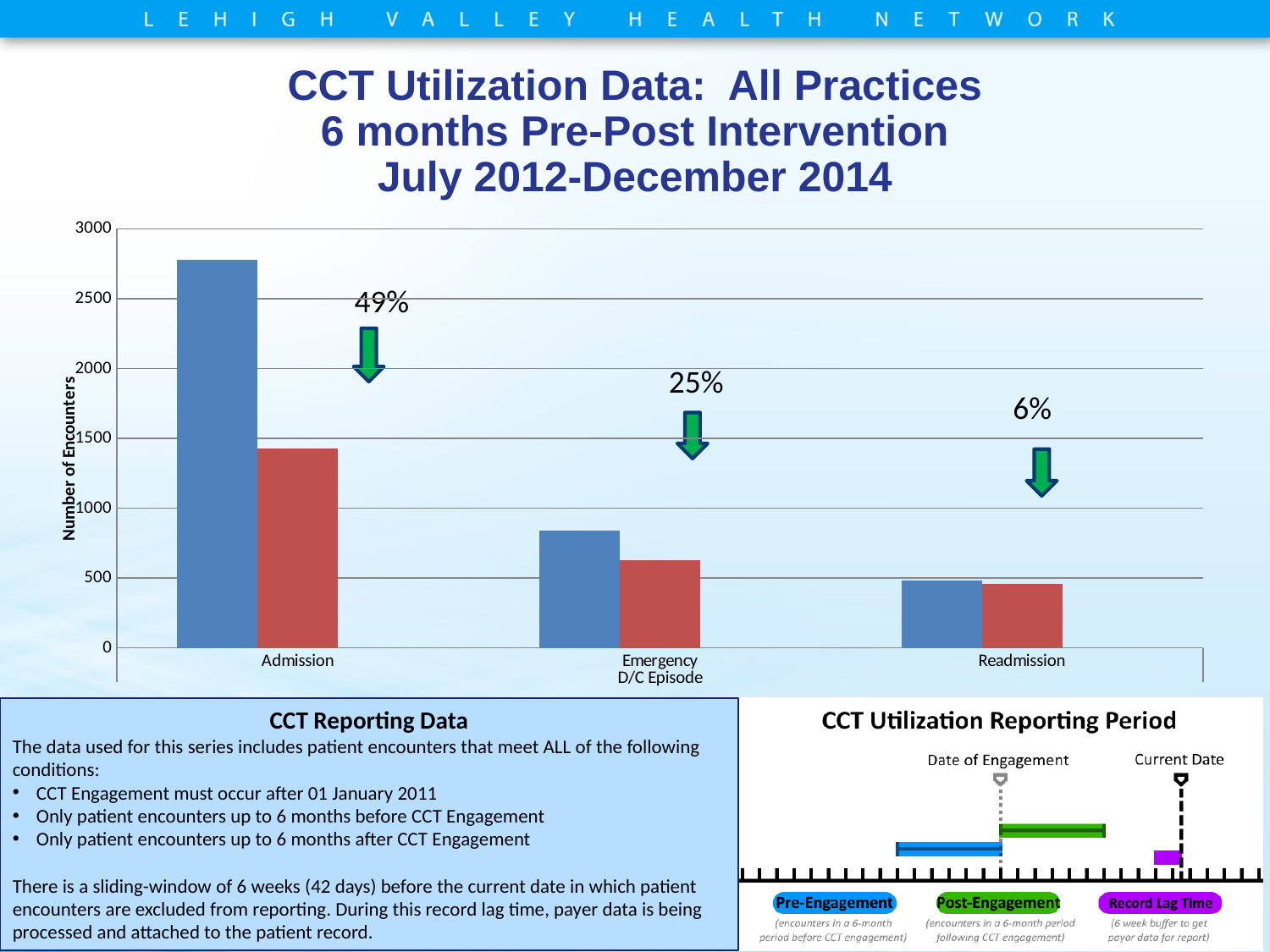
Is the value of the blue Emergency D/C Episode bar greater or less than 1000? less What percentage decrease is annotated above the Readmission bars? 6% How many categories are shown on the x axis of the chart? 3 What percentage decrease is annotated above the Emergency D/C Episode bars? 25% What is the title of the y axis of the chart? Number of Encounters For the Admission category, which bar is taller, the blue one or the red one? the blue one Which category has the shortest bars in the chart? Readmission What percentage decrease is annotated above the Admission bars? 49% Is the value of the red Emergency D/C Episode bar greater or less than 500? greater Is the value of the blue Admission bar greater or less than 2500? greater Which category has the tallest bar in the chart? Admission What kind of chart is shown on the slide? bar chart